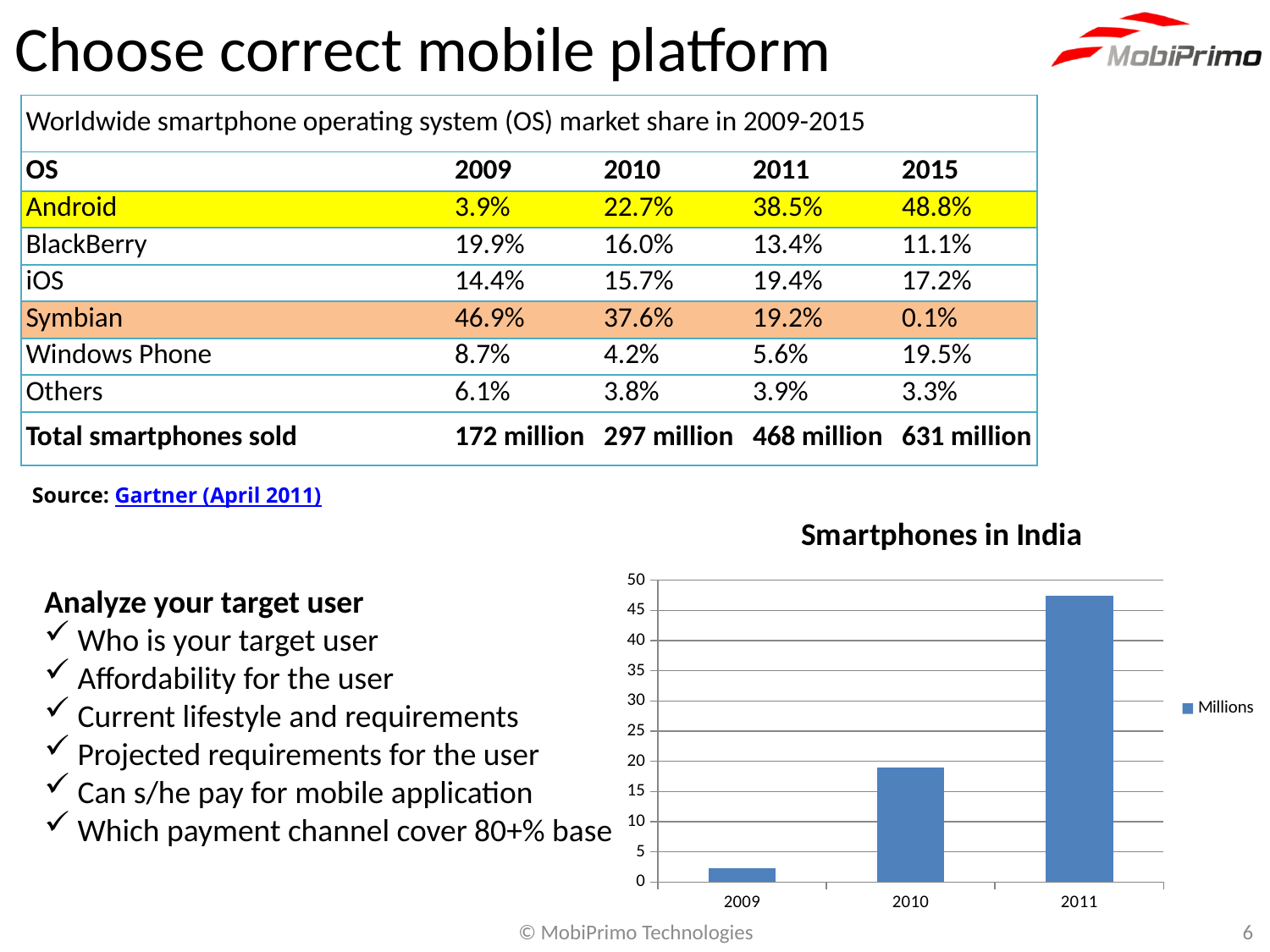
How many bars are plotted in the "Smartphones in India" chart? 3 In the "Smartphones in India" chart, is the value for 2009 greater or less than 5? less Which year has the highest value in the "Smartphones in India" chart? 2011 In the "Smartphones in India" chart, is the value for 2010 greater or less than 15? greater In the "Smartphones in India" chart, is the value for 2011 greater or less than 40? greater Which year has the lowest value in the "Smartphones in India" chart? 2009 In the "Smartphones in India" chart, which is larger, the value for 2010 or the value for 2011? 2011 What is the title of the bar chart on the slide? Smartphones in India In the "Smartphones in India" chart, do the values rise or fall from 2009 to 2011? rise What kind of chart is the "Smartphones in India" chart? bar chart How many series does the legend of the "Smartphones in India" chart list? 1 What is the legend entry shown in the "Smartphones in India" chart? Millions